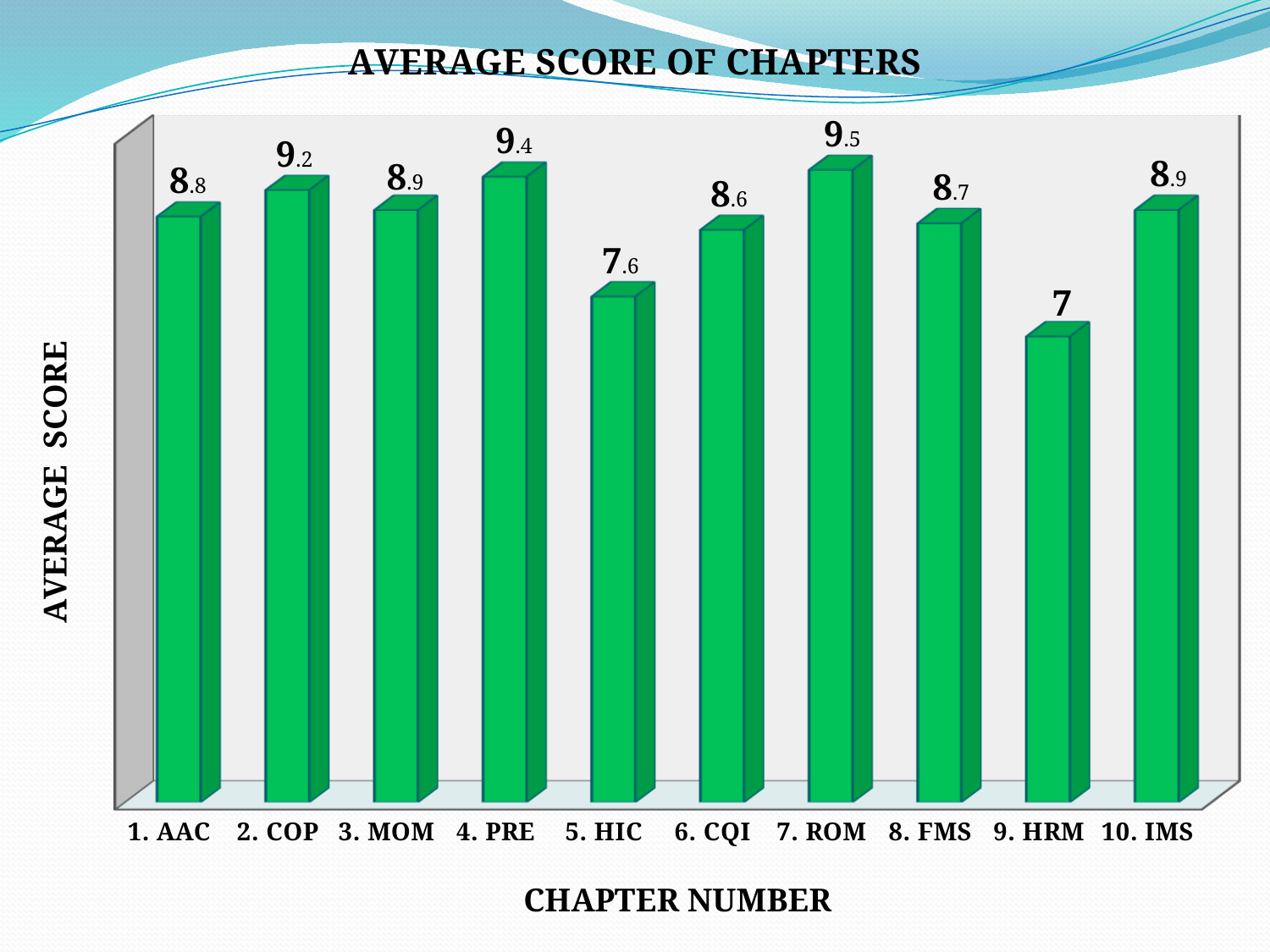
Which chapter has the lowest average score? 9. HRM What kind of chart is shown on the slide? Bar chart Which has a higher average score, 5. HIC or 6. CQI? 6. CQI What is the average score for chapter 9. HRM? 7 What is the title of the chart? AVERAGE SCORE OF CHAPTERS What is the average score for chapter 6. CQI? 8.6 How many chapters are shown on the chart? 10 Which has a higher average score, 1. AAC or 8. FMS? 1. AAC What is the difference between the average scores of 2. COP and 5. HIC? 1.6 What is the difference between the average scores of 7. ROM and 9. HRM? 2.5 What is the average score for chapter 4. PRE? 9.4 Which chapter has the highest average score? 7. ROM